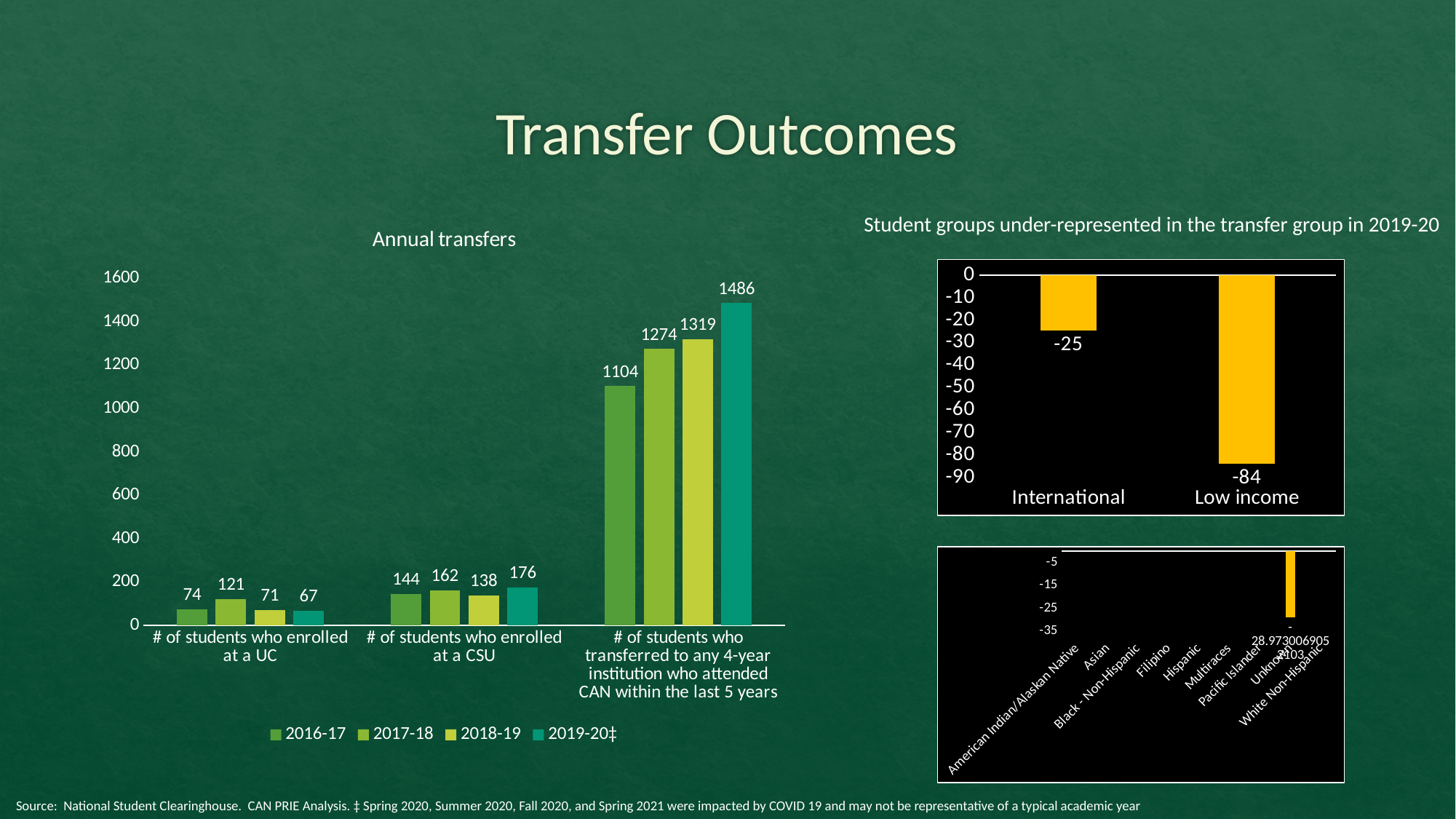
In the Annual transfers chart, what is the 2019-20‡ value for # of students who enrolled at a CSU? 176 In the Student groups under-represented in the transfer group in 2019-20 chart, what is the value for International? -25 In the Annual transfers chart, how many students enrolled at a UC in 2017-18? 121 In the Annual transfers chart, what is the difference between the 2019-20‡ and 2018-19 values for students who transferred to any 4-year institution? 167 How many series does the legend of the Annual transfers chart list? 4 In the Annual transfers chart, what is the 2016-17 value for # of students who transferred to any 4-year institution who attended CAN within the last 5 years? 1104 In the Student groups under-represented in the transfer group in 2019-20 chart, what is the difference between the International and Low income values? 59 In the Annual transfers chart, which year has the lowest number of students who enrolled at a UC? 2019-20‡ What kind of chart is the Annual transfers chart? Bar chart In the Annual transfers chart, which is larger: the 2017-18 value for enrolled at a CSU or the 2018-19 value for enrolled at a CSU? 2017-18 In the Student groups under-represented in the transfer group in 2019-20 chart, what is the value for Low income? -84 In the Annual transfers chart, which year has the highest number of students who transferred to any 4-year institution? 2019-20‡